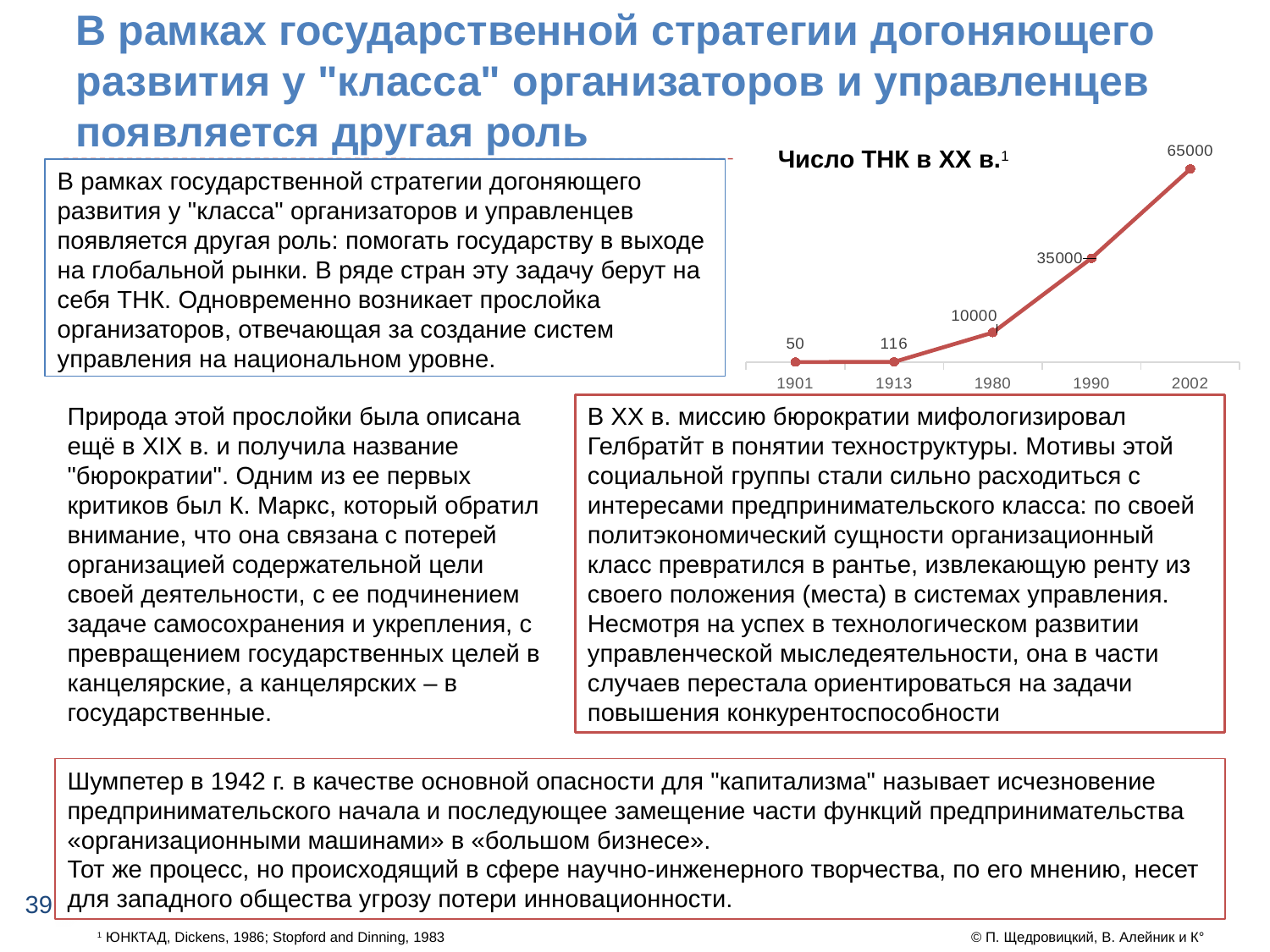
What type of chart is shown on the slide? line chart What is the title of the chart? Число ТНК в XX в. What is the difference between the values for 2002 and 1990? 30000 What is the value for 1913 in the chart? 116 Do the values rise or fall from 1901 to 2002? rise How many data points are plotted in the chart? 5 What is the value for 1980 in the chart? 10000 What is the value for 1990 in the chart? 35000 What is the value for 2002 in the chart? 65000 Which year has the highest value in the chart? 2002 Which year has the lowest value in the chart? 1901 What is the value for 1901 in the chart? 50